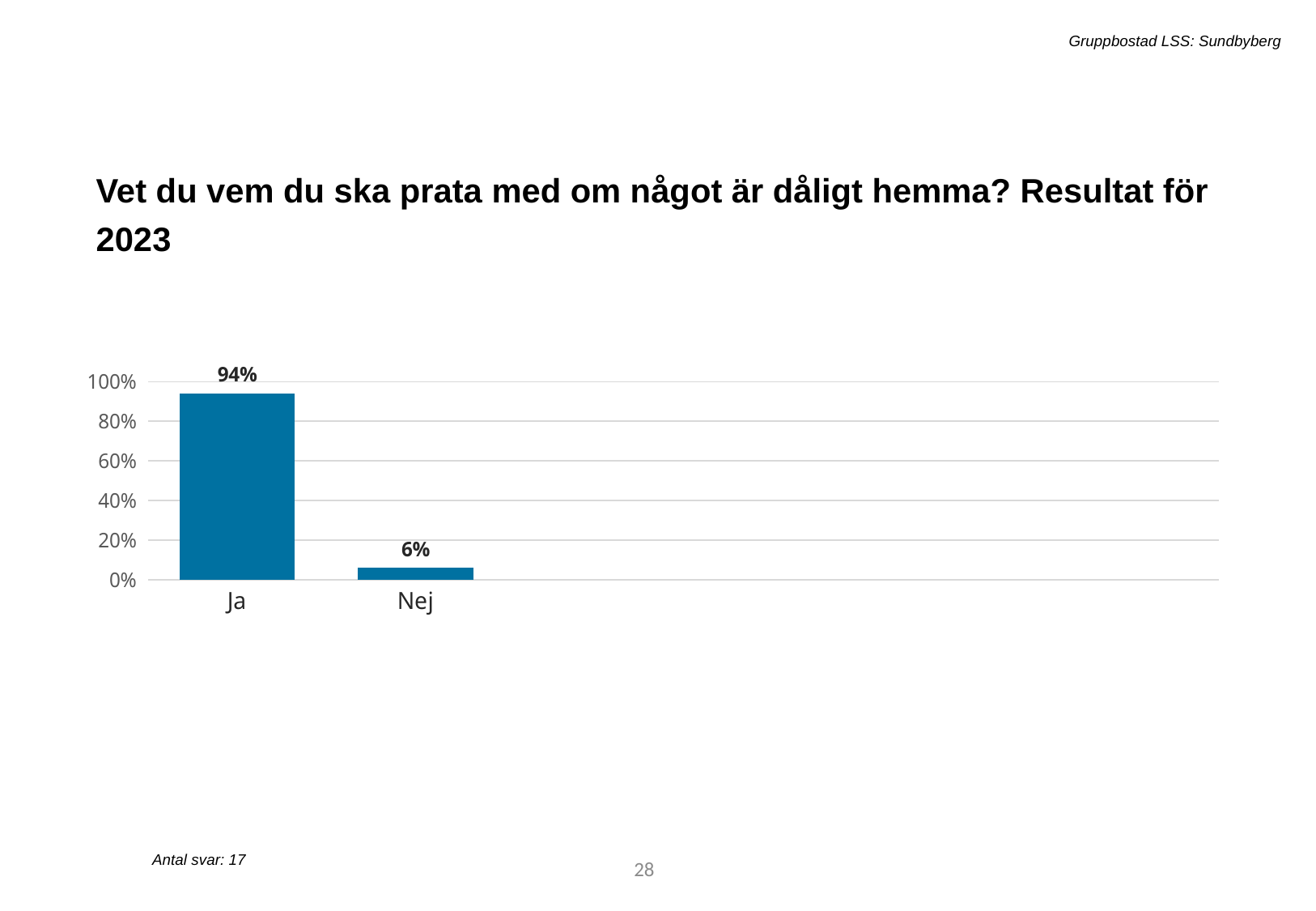
Which is larger, the value for Ja or the value for Nej? Ja What is the value for Ja? 94% How many responses (Antal svar) does the slide report? 17 Which category has the highest value? Ja Is the value for Ja greater or less than 80%? greater What is the total of the two bar values? 100% How many categories are shown on the x axis? 2 Which category has the lowest value? Nej What kind of chart is shown on the slide? bar chart Is the value for Nej greater or less than 20%? less What is the value for Nej? 6% What is the difference between the values for Ja and Nej? 88%